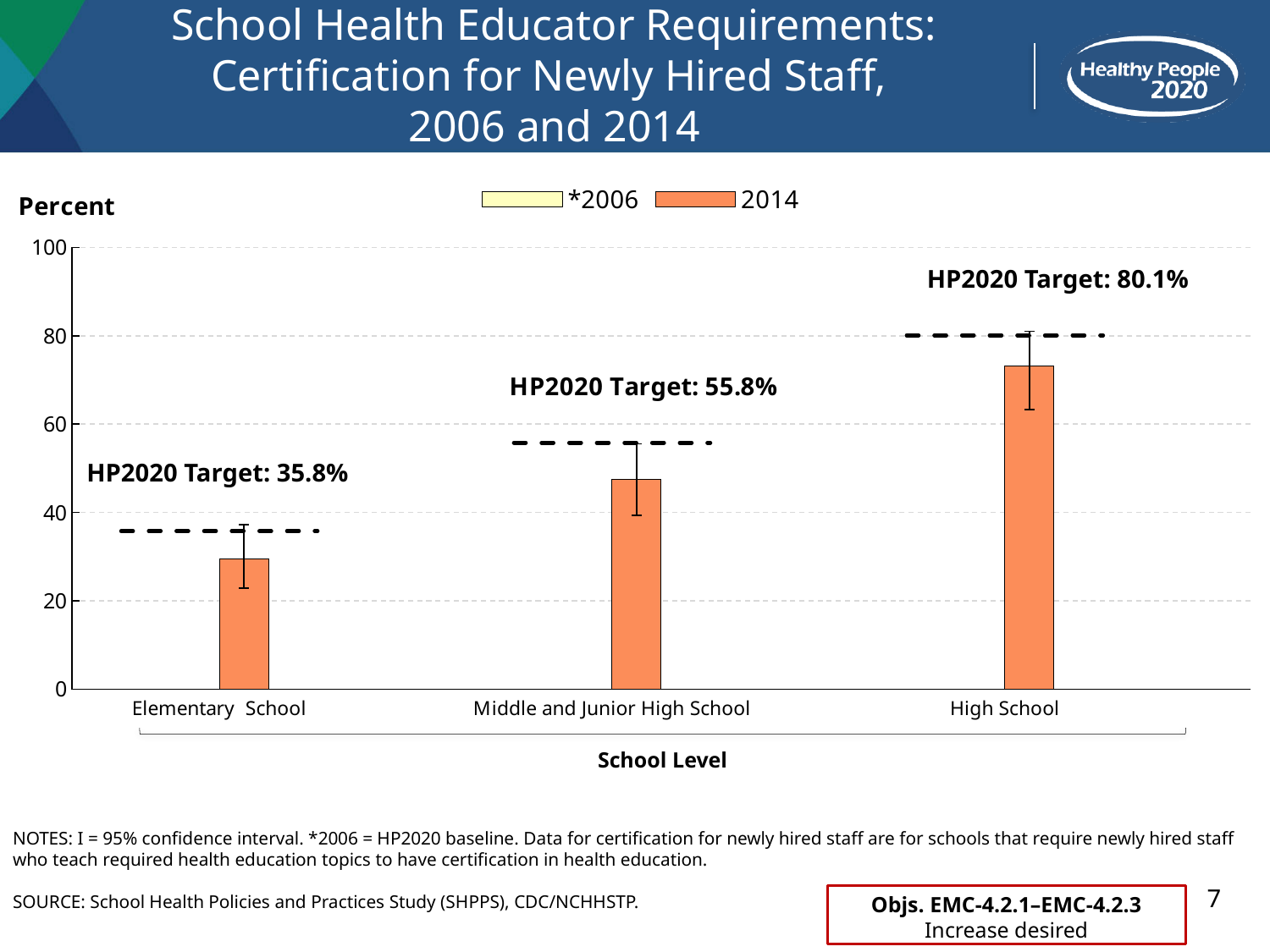
What is the HP2020 Target shown for Elementary School? 35.8% How many series does the legend list? 2 Which has a larger 2014 value, Middle and Junior High School or Elementary School? Middle and Junior High School Which school level has the lowest 2014 bar? Elementary School Is the 2014 value for Elementary School greater or less than 40? less How many school levels are shown on the x axis? 3 Is the 2014 value for Middle and Junior High School greater or less than 40? greater What is the HP2020 Target shown for High School? 80.1% Is the 2014 value for High School greater or less than 60? greater What is the title of the x axis? School Level Which school level has the highest 2014 bar? High School What kind of chart is shown on the slide? Bar chart